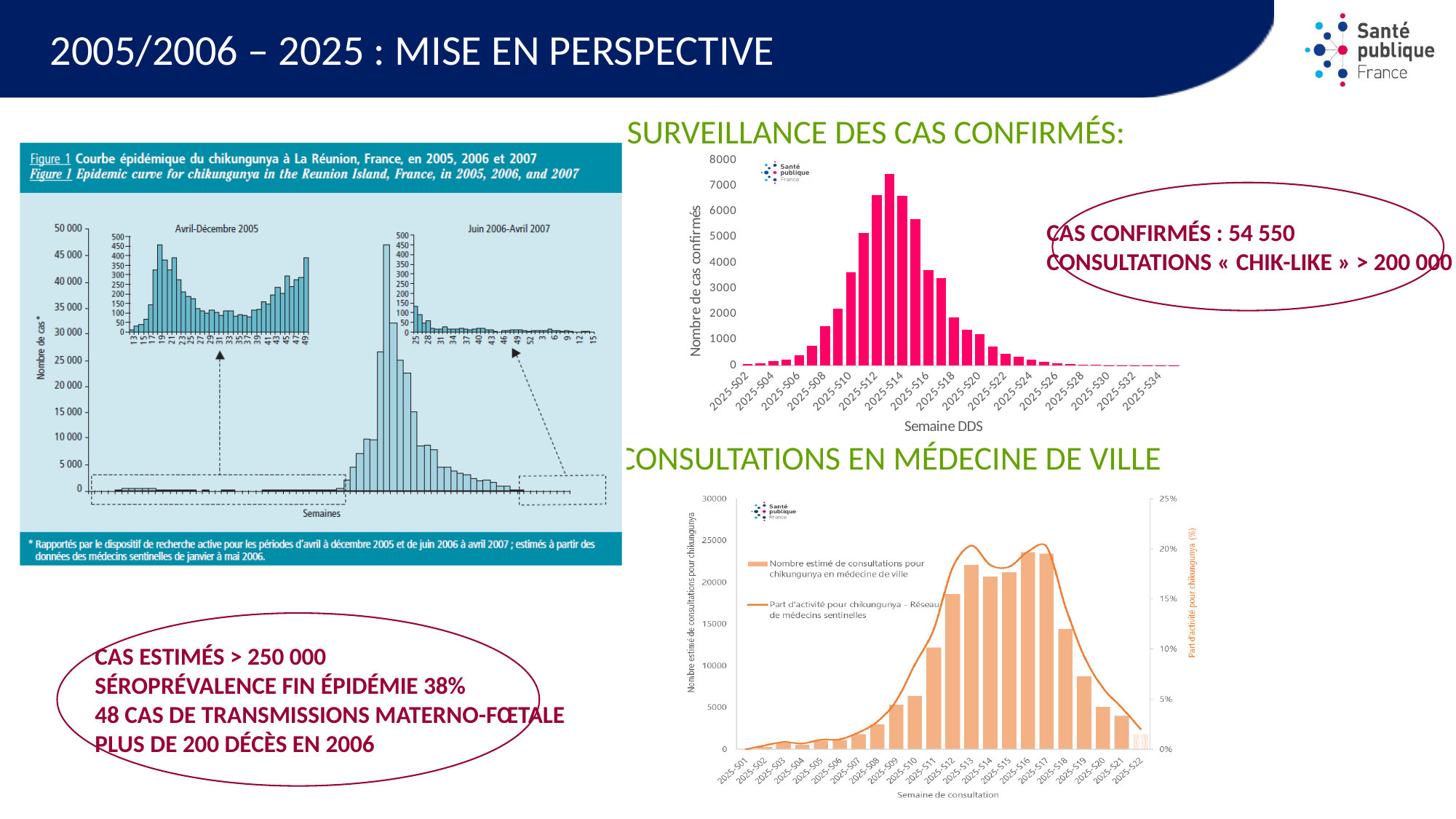
In the 'Surveillance des cas confirmés' chart, what is the label of the x axis? Semaine DDS What kind of chart is the 'Surveillance des cas confirmés' chart at the top right? Bar chart In the 'Surveillance des cas confirmés' chart, is the value for 2025-S10 greater or less than 3000? greater In the 'Surveillance des cas confirmés' chart, which week has the highest number of confirmed cases? 2025-S13 How many series does the legend of the 'Consultations en médecine de ville' chart list? 2 In the 'Surveillance des cas confirmés' chart, is the value for 2025-S14 greater or less than 7000? less In the 'Consultations en médecine de ville' chart, is the estimated number of consultations for 2025-S13 greater or less than 20000? greater In the 'Surveillance des cas confirmés' chart, do the values rise or fall from 2025-S16 to 2025-S26? fall